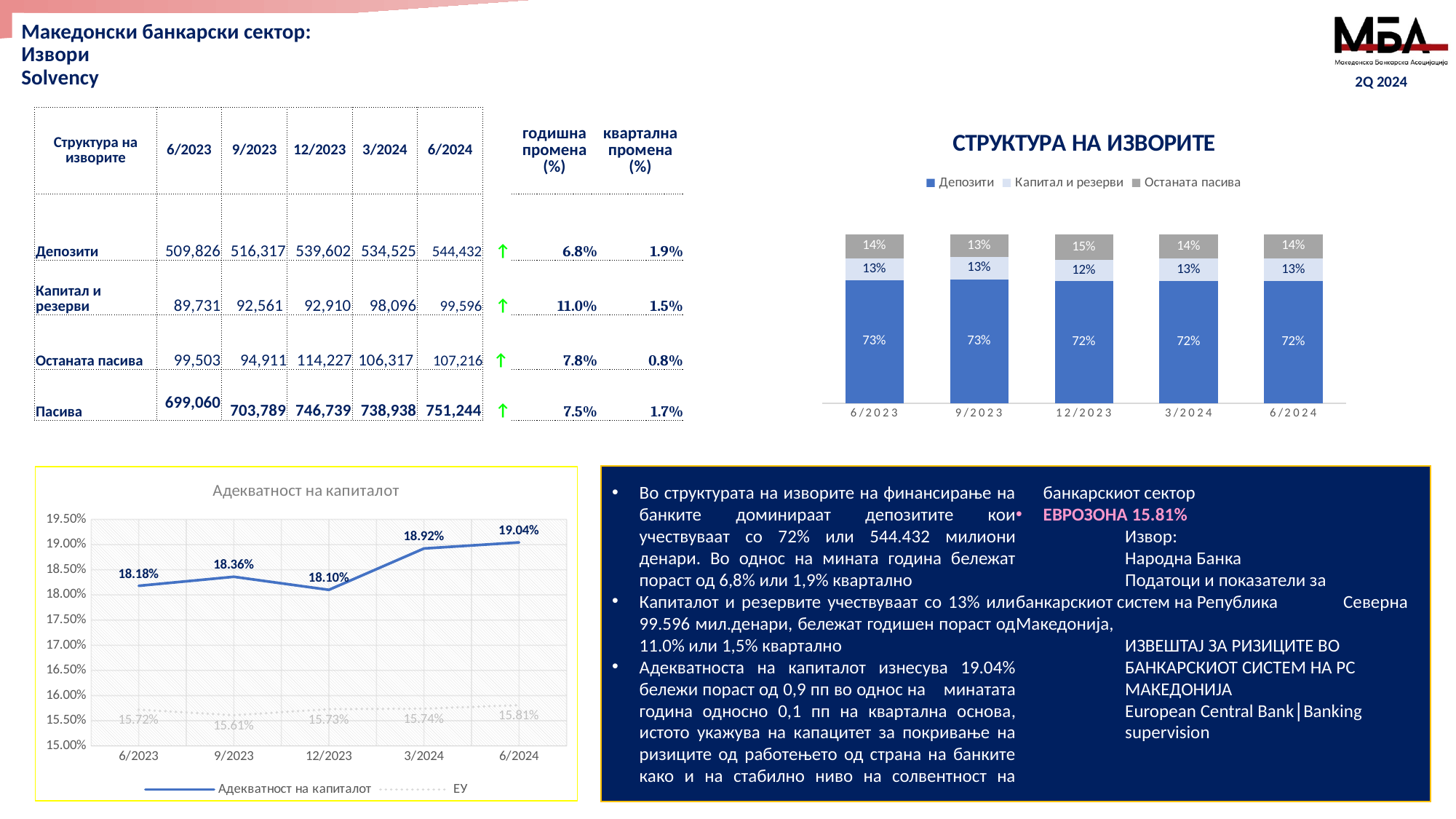
In the chart titled 'СТРУКТУРА НА ИЗВОРИТЕ', how many periods are shown on the x axis? 5 In the chart titled 'Адекватност на капиталот', what is the difference between Адекватност на капиталот and ЕУ in 6/2024? 3.23% In the chart titled 'СТРУКТУРА НА ИЗВОРИТЕ', what is the share of Депозити in 6/2024? 72% In the chart titled 'Адекватност на капиталот', in which period is Адекватност на капиталот lowest? 12/2023 In the chart titled 'Адекватност на капиталот', what is the ЕУ value for 9/2023? 15.61% In the chart titled 'СТРУКТУРА НА ИЗВОРИТЕ', what is the difference between the Депозити share in 6/2023 and in 6/2024? 1% What kind of chart is 'СТРУКТУРА НА ИЗВОРИТЕ'? Stacked bar chart In the chart titled 'СТРУКТУРА НА ИЗВОРИТЕ', what is the share of Останата пасива in 12/2023? 15% In the chart titled 'СТРУКТУРА НА ИЗВОРИТЕ', how many series does the legend list? 3 In the chart titled 'Адекватност на капиталот', which is larger in 12/2023: Адекватност на капиталот or ЕУ? Адекватност на капиталот In the chart titled 'Адекватност на капиталот', in which period is Адекватност на капиталот highest? 6/2024 In the chart titled 'Адекватност на капиталот', what is the value of Адекватност на капиталот for 3/2024? 18.92%